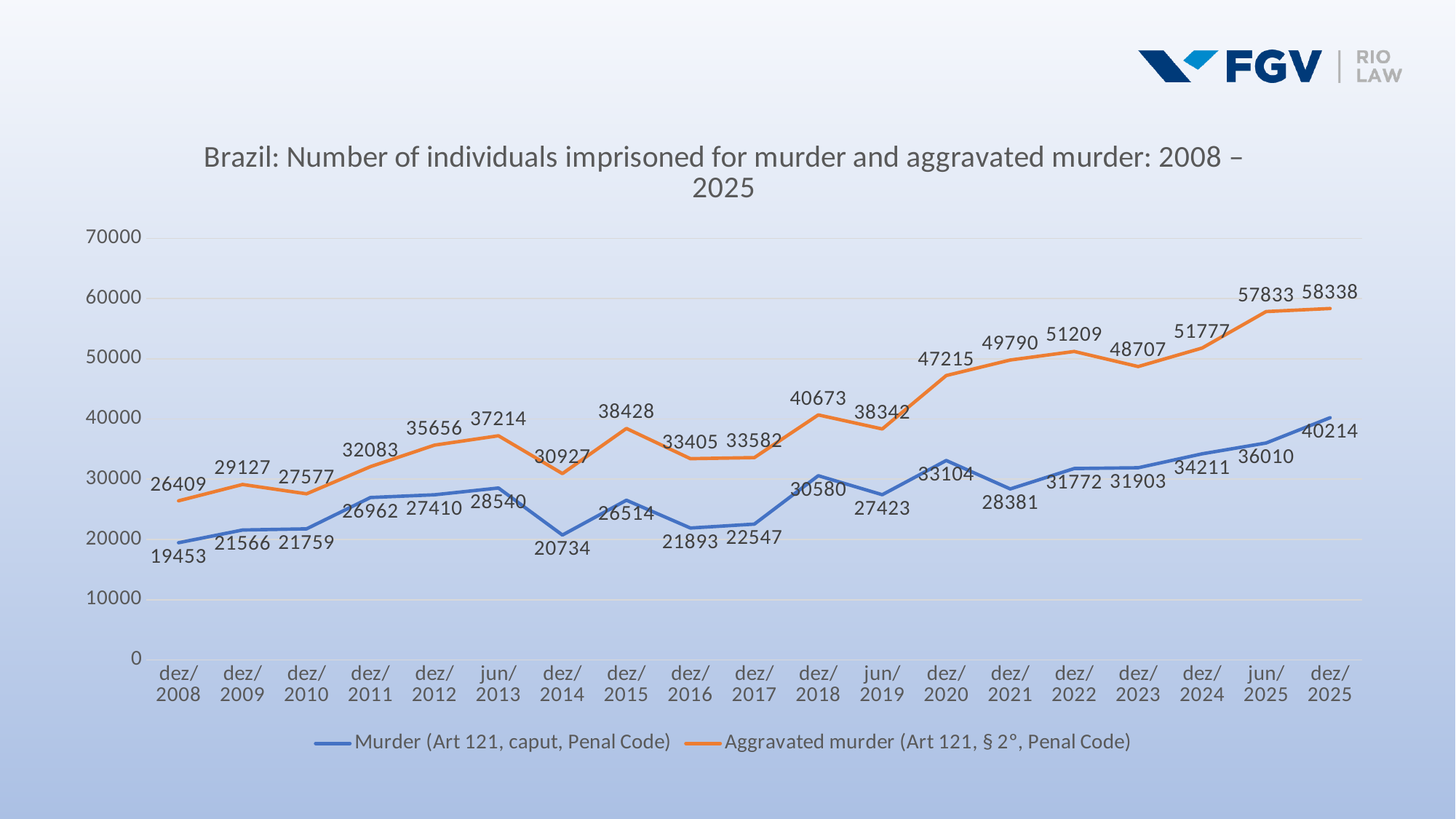
What is the value of the Murder (Art 121, caput, Penal Code) series at dez/2008? 19453 At which point on the x axis does the Aggravated murder series reach its highest value? dez/2025 What is the value of the Murder (Art 121, caput, Penal Code) series at jun/2019? 27423 Which is larger for the Murder series: the value at dez/2014 or the value at dez/2015? dez/2015 By how much did the Aggravated murder series increase from dez/2024 to jun/2025? 6056 What kind of chart is shown on the slide? line chart What is the value of the Aggravated murder (Art 121, § 2°, Penal Code) series at dez/2025? 58338 How many points are plotted along the x axis for each series? 19 At dez/2025, what is the difference between the Aggravated murder value and the Murder value? 18124 How many series does the legend list? 2 Does the Aggravated murder series rise or fall from dez/2020 to dez/2022? rise At which point on the x axis is the Murder (Art 121, caput, Penal Code) series lowest? dez/2008